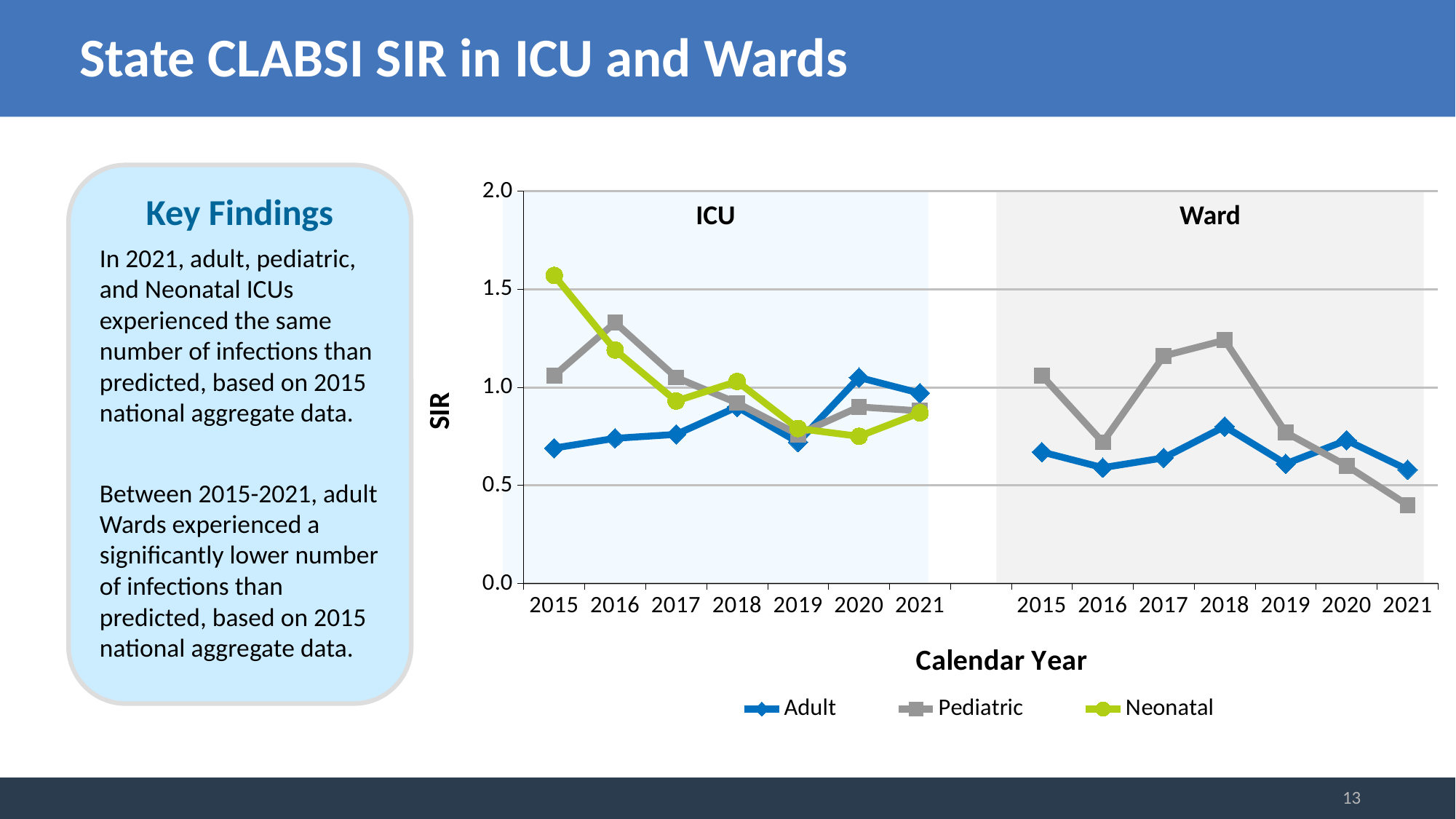
What is the title of the vertical axis? SIR How many calendar years are plotted in the ICU panel? 7 How many series does the legend list? 3 In the ICU panel, is the Adult value for 2020 greater or less than 1.0? greater In the Ward panel, in which year is the Pediatric SIR highest? 2018 In the ICU panel, in which year is the Pediatric SIR highest? 2016 In the ICU panel, does the Neonatal SIR rise or fall from 2015 to 2017? fall What kind of chart is shown on the slide? line chart In the ICU panel, in which year is the Neonatal SIR highest? 2015 In the ICU panel for 2016, which is larger, the Pediatric SIR or the Adult SIR? Pediatric In the ICU panel, is the Neonatal value for 2015 greater or less than 1.5? greater In the Ward panel, is the Pediatric value for 2021 greater or less than 0.5? less